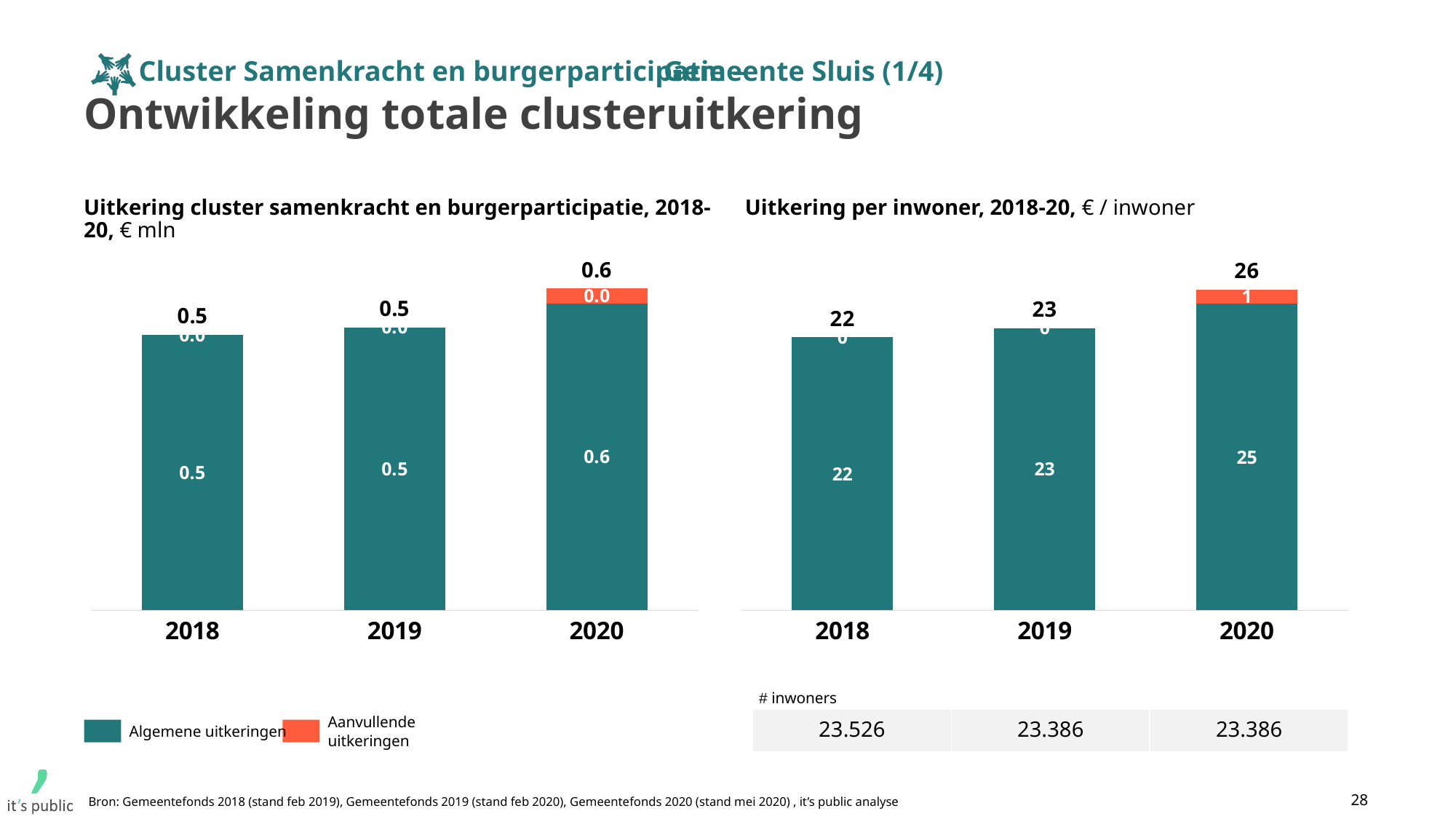
In the right chart (Uitkering per inwoner), what is the value of Algemene uitkeringen for 2020? 25 In the right chart (Uitkering per inwoner), is the total for 2020 larger or smaller than the total for 2019? larger In the right chart (Uitkering per inwoner), which year has the lowest total? 2018 How many years are shown on the x axis of the left chart (Uitkering cluster samenkracht en burgerparticipatie)? 3 In the right chart (Uitkering per inwoner), what is the difference between the total for 2020 and the total for 2018? 4 In the left chart (Uitkering cluster samenkracht en burgerparticipatie), what is the value of Algemene uitkeringen for 2018? 0.5 In the left chart (Uitkering cluster samenkracht en burgerparticipatie), what is the total value for 2020? 0.6 In the right chart (Uitkering per inwoner), what is the total value for 2019? 23 In the right chart (Uitkering per inwoner), what is the value of Aanvullende uitkeringen for 2020? 1 What type of chart is the right chart (Uitkering per inwoner)? Stacked bar chart In the right chart (Uitkering per inwoner), which year has the highest total? 2020 How many series does the legend list for the charts on this slide? 2